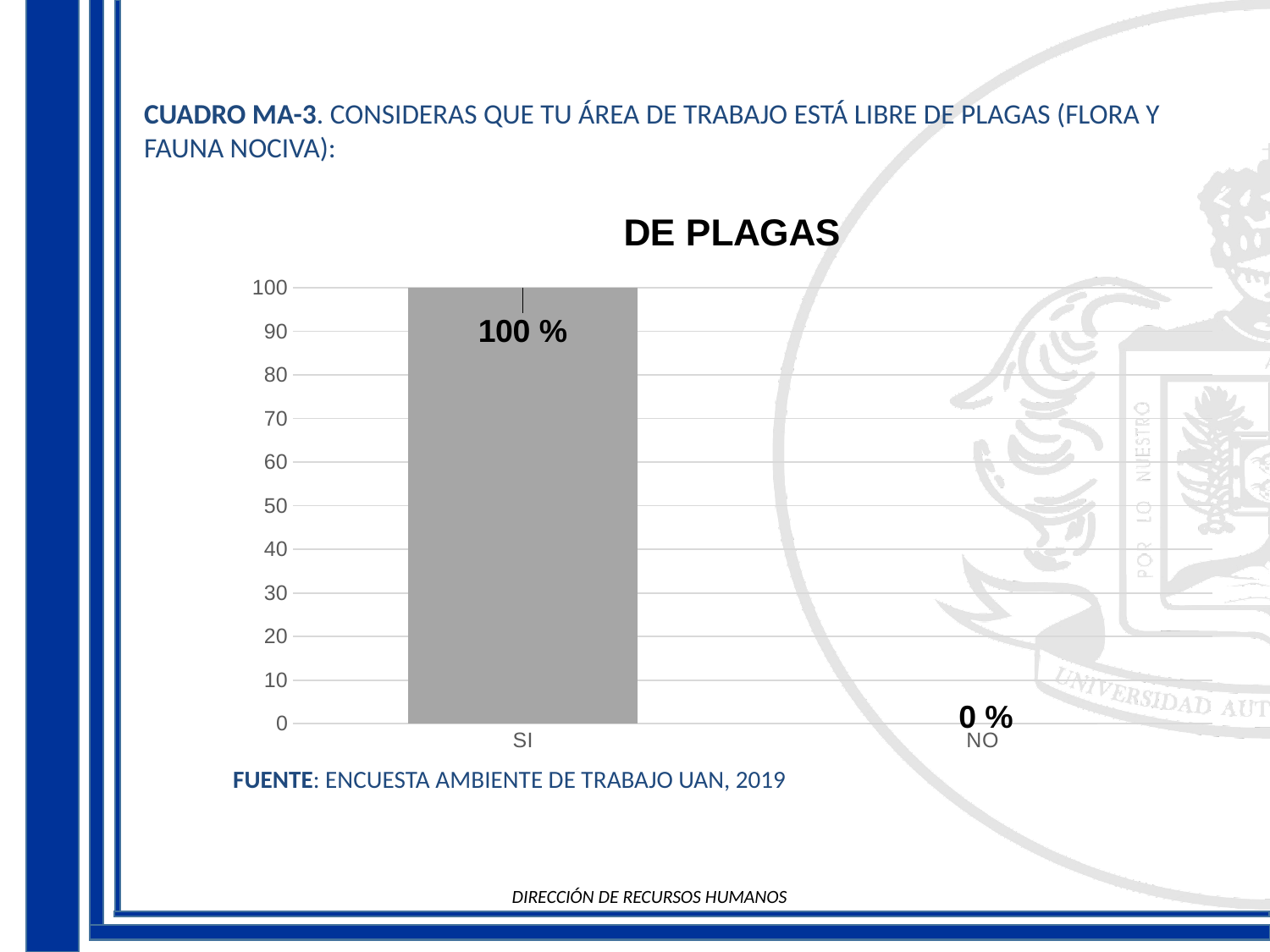
Which category has the lowest value? NO How many categories are shown on the x axis? 2 Which is larger, the value for SI or the value for NO? SI Which category has the highest value? SI What is the highest value shown on the y axis? 100 What is the value for SI? 100 % What is the title of the chart? DE PLAGAS Is the value for SI greater or less than 50? greater What is the value for NO? 0 % What is the difference between the values for SI and NO? 100 % Do the values rise or fall from SI to NO? fall What kind of chart is shown on the slide? bar chart